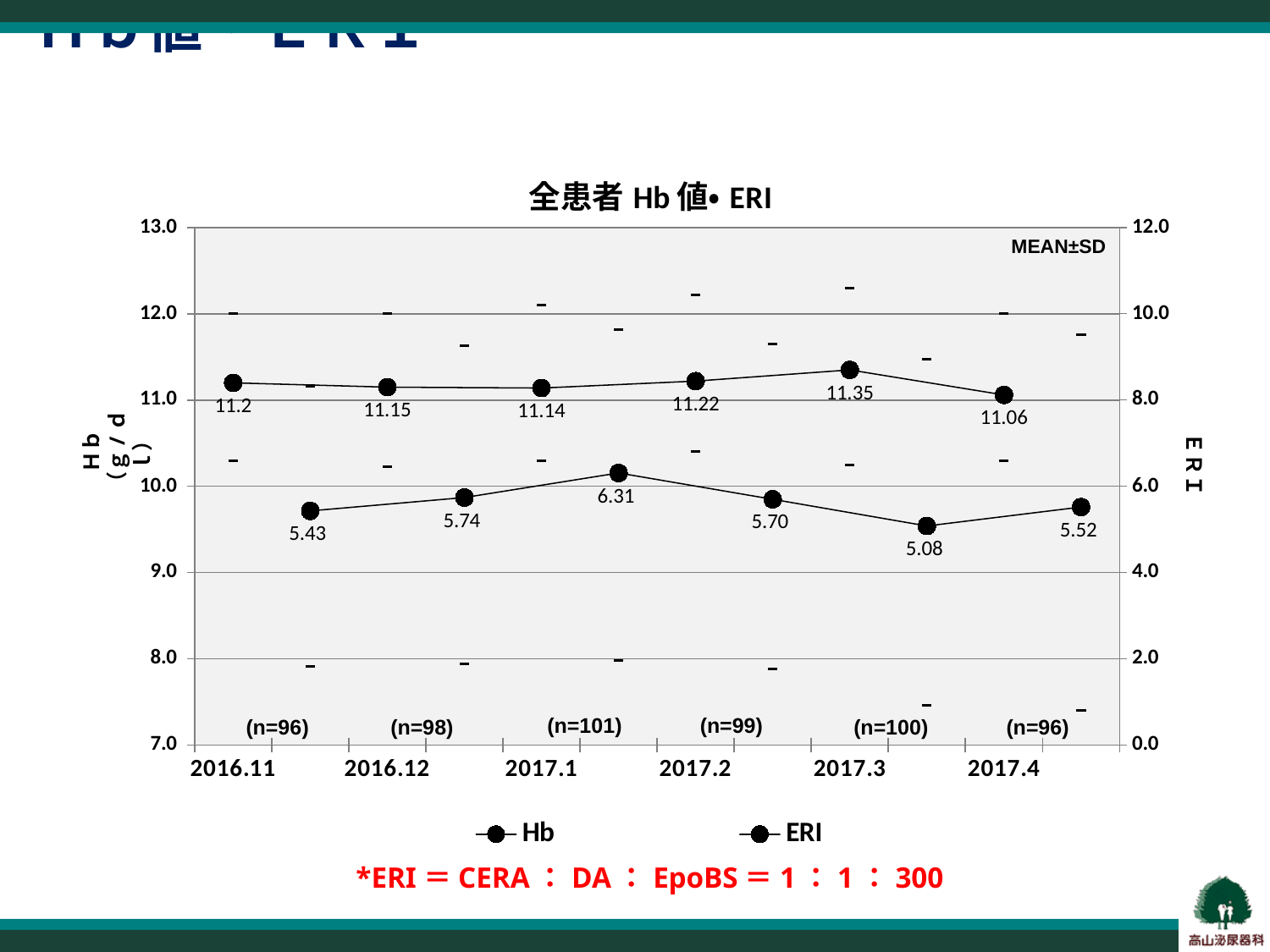
What is the ERI value for 2017.1? 6.31 How many time points are plotted on the x axis? 6 Which month has the lowest ERI value? 2017.3 What is the Hb value for 2016.11? 11.2 Which month has the lowest Hb value? 2017.4 What kind of chart is shown on the slide? Line chart How many series does the legend list? 2 What is the difference between the ERI values for 2017.1 and 2017.3? 1.23 Which month has the highest Hb value? 2017.3 Is the ERI value for 2016.12 or 2017.2 larger? 2016.12 What is the ERI value for 2017.3? 5.08 What is the Hb value for 2017.3? 11.35